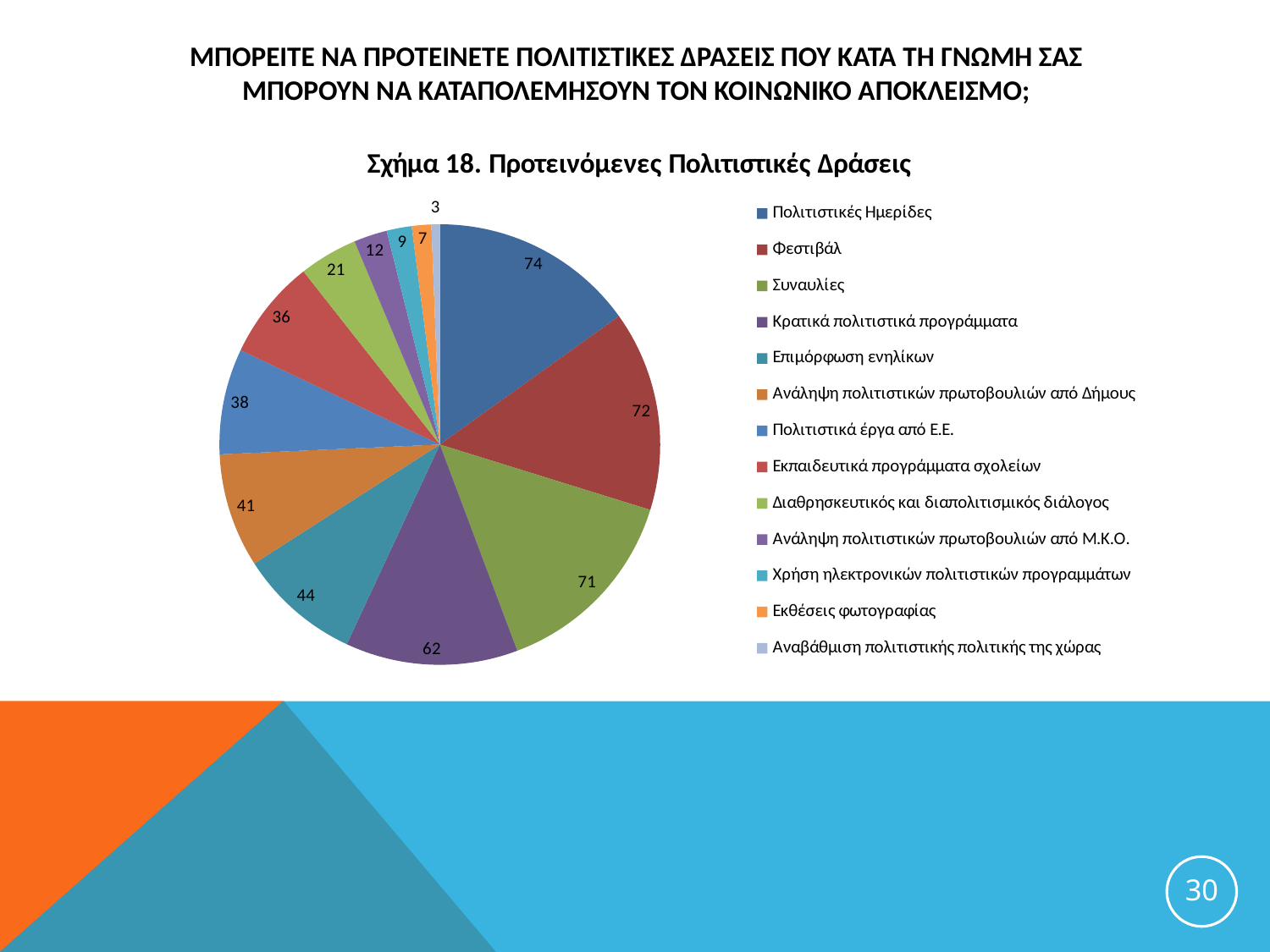
What kind of chart is shown on the slide? Pie chart What is the value for Κρατικά πολιτιστικά προγράμματα? 62 What is the difference between the values for Συναυλίες and Επιμόρφωση ενηλίκων? 27 Which is larger, Ανάληψη πολιτιστικών πρωτοβουλιών από Δήμους or Πολιτιστικά έργα από Ε.Ε.? Ανάληψη πολιτιστικών πρωτοβουλιών από Δήμους What is the value for Εκθέσεις φωτογραφίας? 7 Which category has the largest slice? Πολιτιστικές Ημερίδες How many categories does the legend list? 13 What is the title of the chart? Σχήμα 18. Προτεινόμενες Πολιτιστικές Δράσεις Which category has the smallest slice? Αναβάθμιση πολιτιστικής πολιτικής της χώρας What is the value for Πολιτιστικές Ημερίδες? 74 What is the value for Φεστιβάλ? 72 What is the value for Εκπαιδευτικά προγράμματα σχολείων? 36